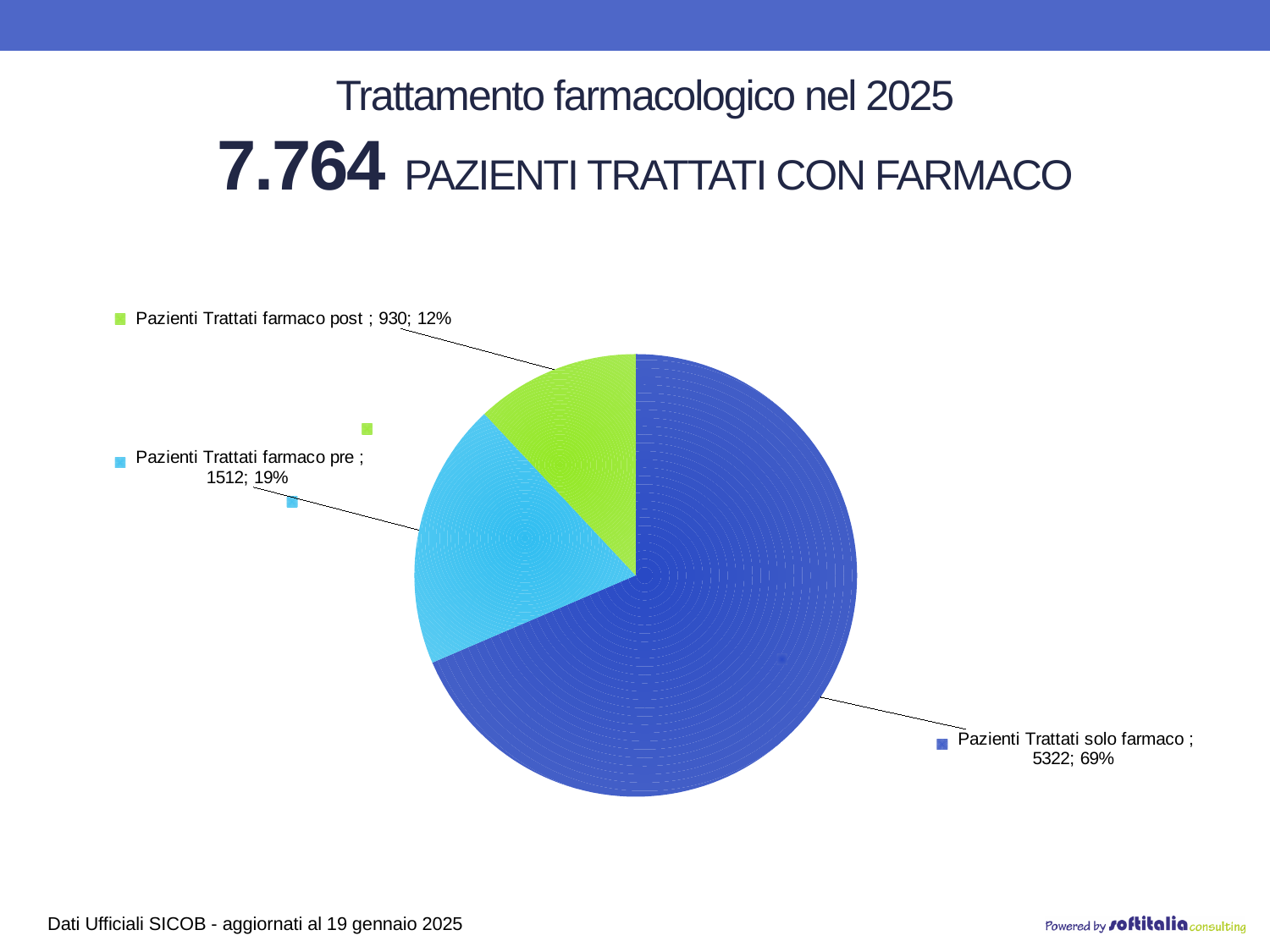
What share of the pie does Pazienti Trattati farmaco pre represent? 19% What is the value for Pazienti Trattati farmaco post? 930 What type of chart is shown on the slide? Pie chart What share of the pie does Pazienti Trattati solo farmaco represent? 69% Which is larger, the value for Pazienti Trattati farmaco pre or Pazienti Trattati farmaco post? Pazienti Trattati farmaco pre What share of the pie does Pazienti Trattati farmaco post represent? 12% Which category has the smallest slice of the pie? Pazienti Trattati farmaco post What is the difference between the values for Pazienti Trattati farmaco pre and Pazienti Trattati farmaco post? 582 What is the value for Pazienti Trattati solo farmaco? 5322 What is the value for Pazienti Trattati farmaco pre? 1512 Which category has the largest slice of the pie? Pazienti Trattati solo farmaco How many slices does the pie chart have? 3